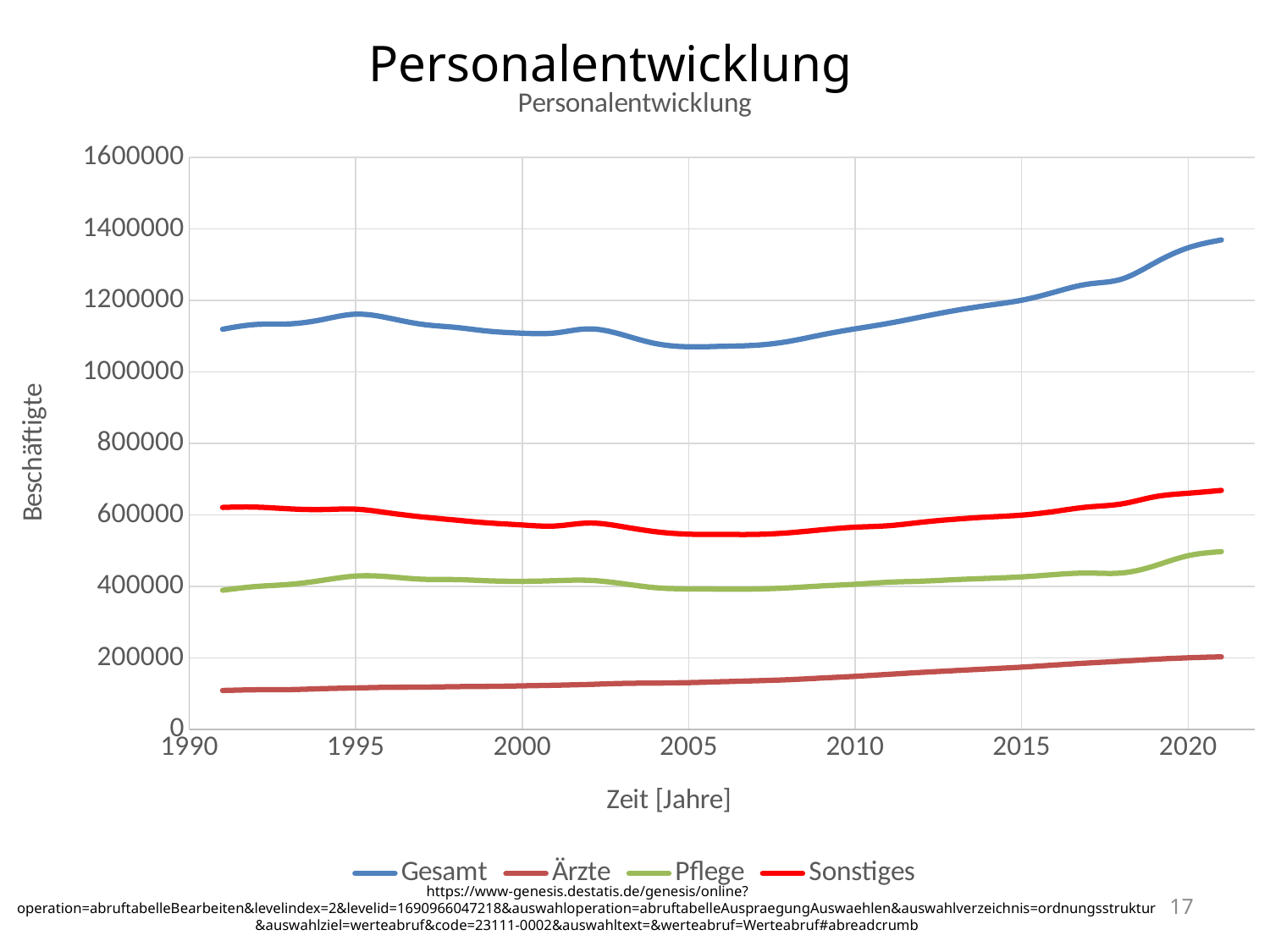
How many series does the legend list? 4 Which series has the lowest values across the whole period? Ärzte Is the value for Ärzte in 2020 greater or less than 400000? less In 2010, which is larger: Pflege or Sonstiges? Sonstiges What kind of chart is shown on the slide? line chart What is the label of the vertical axis? Beschäftigte Does the Ärzte series rise or fall from 1991 to 2021? rise Does the Gesamt series rise or fall between 1995 and 2005? fall Is the value for Gesamt in 2020 greater or less than 1200000? greater Is the value for Sonstiges in 2005 greater or less than 600000? less Which series has the highest values across the whole period? Gesamt Which series are listed in the legend? Gesamt, Ärzte, Pflege, Sonstiges